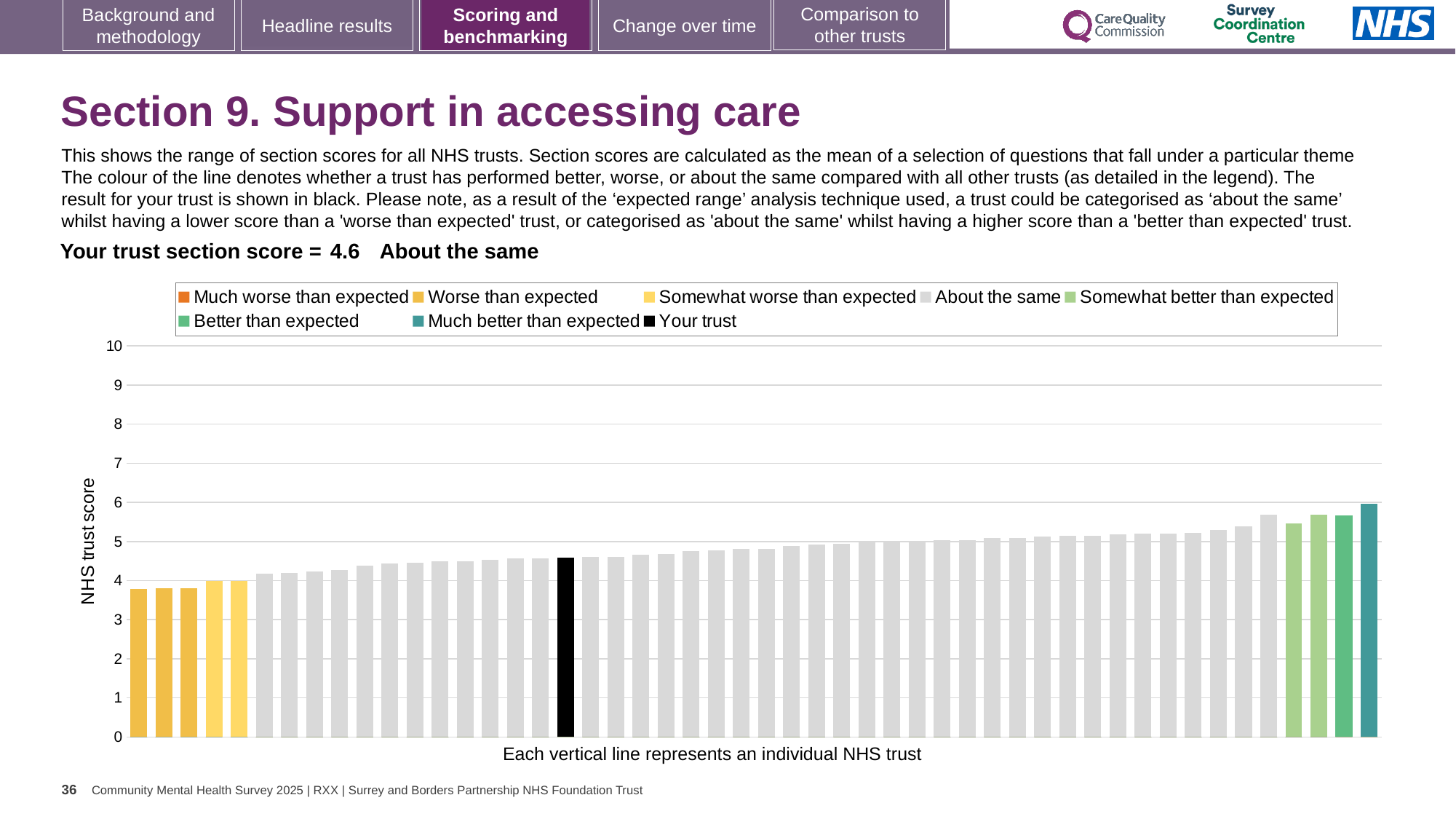
What is the label on the y axis of the chart? NHS trust score Is the value of the tallest bar greater or less than 5? greater Which category is your trust placed in for this section? About the same What colour is the bar representing your trust? Black Which legend category does the tallest bar belong to? Much better than expected Which is larger: the black 'Your trust' bar or the rightmost bar? The rightmost bar What is the section score for your trust shown on the slide? 4.6 What kind of chart is shown on the slide? Bar chart Is the value of the black 'Your trust' bar greater or less than 5? less Do the bar values rise or fall from left to right along the x axis? Rise Is the value of the leftmost (lowest) bar greater or less than 4? less How many entries does the chart legend list? 8